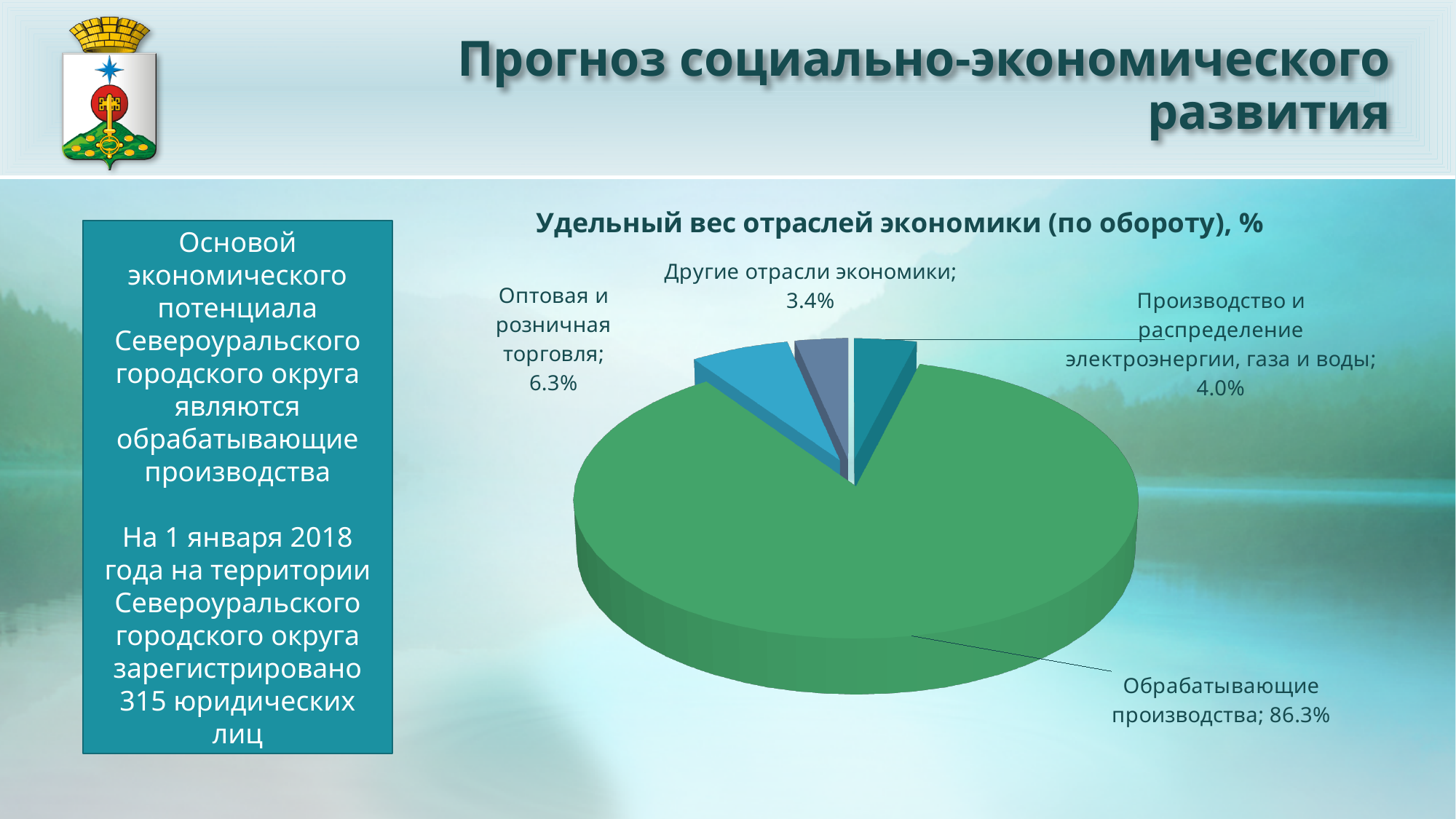
Which sector has the smallest share in the pie chart? Другие отрасли экономики What is the difference in percentage points between Обрабатывающие производства and Оптовая и розничная торговля? 80.0 What is the difference in percentage points between Производство и распределение электроэнергии, газа и воды and Другие отрасли экономики? 0.6 What type of chart is shown on the slide? Pie chart Which sector has the largest share in the pie chart? Обрабатывающие производства What is the share of Оптовая и розничная торговля in the pie chart? 6.3% What is the title of the chart on the slide? Удельный вес отраслей экономики (по обороту), % How many slices does the pie chart have? 4 What is the share of Производство и распределение электроэнергии, газа и воды in the pie chart? 4.0% What is the share of Другие отрасли экономики in the pie chart? 3.4% What is the share of Обрабатывающие производства in the pie chart? 86.3% Which has a larger share: Оптовая и розничная торговля or Производство и распределение электроэнергии, газа и воды? Оптовая и розничная торговля